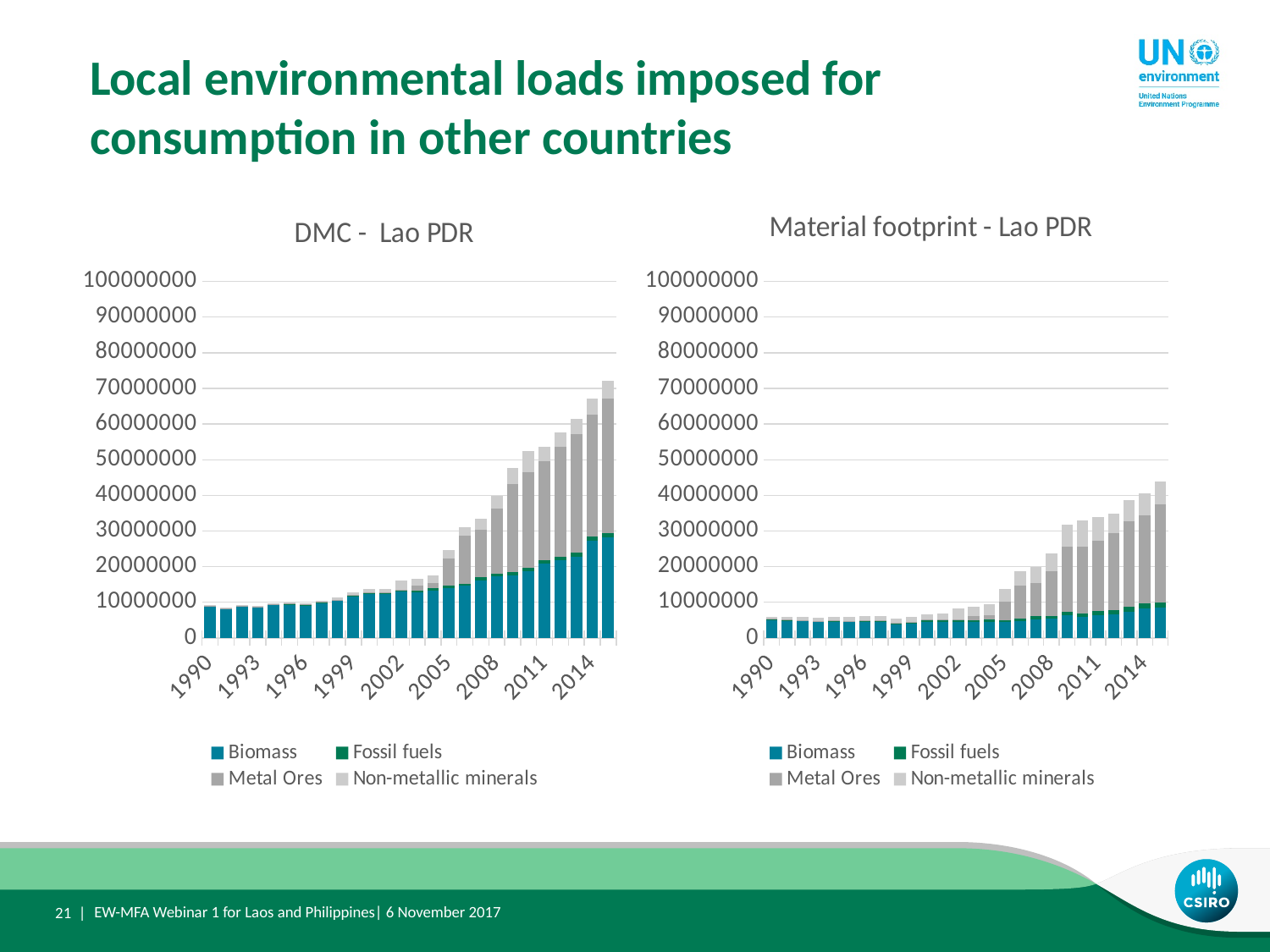
In the 'DMC - Lao PDR' chart, is the total stacked value for 2014 greater or less than 50000000? greater In the 'Material footprint - Lao PDR' chart, is the total stacked value for 2014 greater or less than 50000000? less Which series are listed in the legend of the 'DMC - Lao PDR' chart? Biomass, Fossil fuels, Metal Ores, Non-metallic minerals How many series does the legend of the 'Material footprint - Lao PDR' chart list? 4 In the 'DMC - Lao PDR' chart, do the total values rise or fall from 1990 to 2014? Rise In the 'Material footprint - Lao PDR' chart, is the total stacked value for 2014 greater or less than 30000000? greater Which is larger for 2014: the total in the 'DMC - Lao PDR' chart or the total in the 'Material footprint - Lao PDR' chart? DMC - Lao PDR What kind of chart is the 'DMC - Lao PDR' chart? Stacked bar chart What is the title of the chart on the right side of the slide? Material footprint - Lao PDR In the 'Material footprint - Lao PDR' chart, do the total values rise or fall from 1990 to 2014? Rise